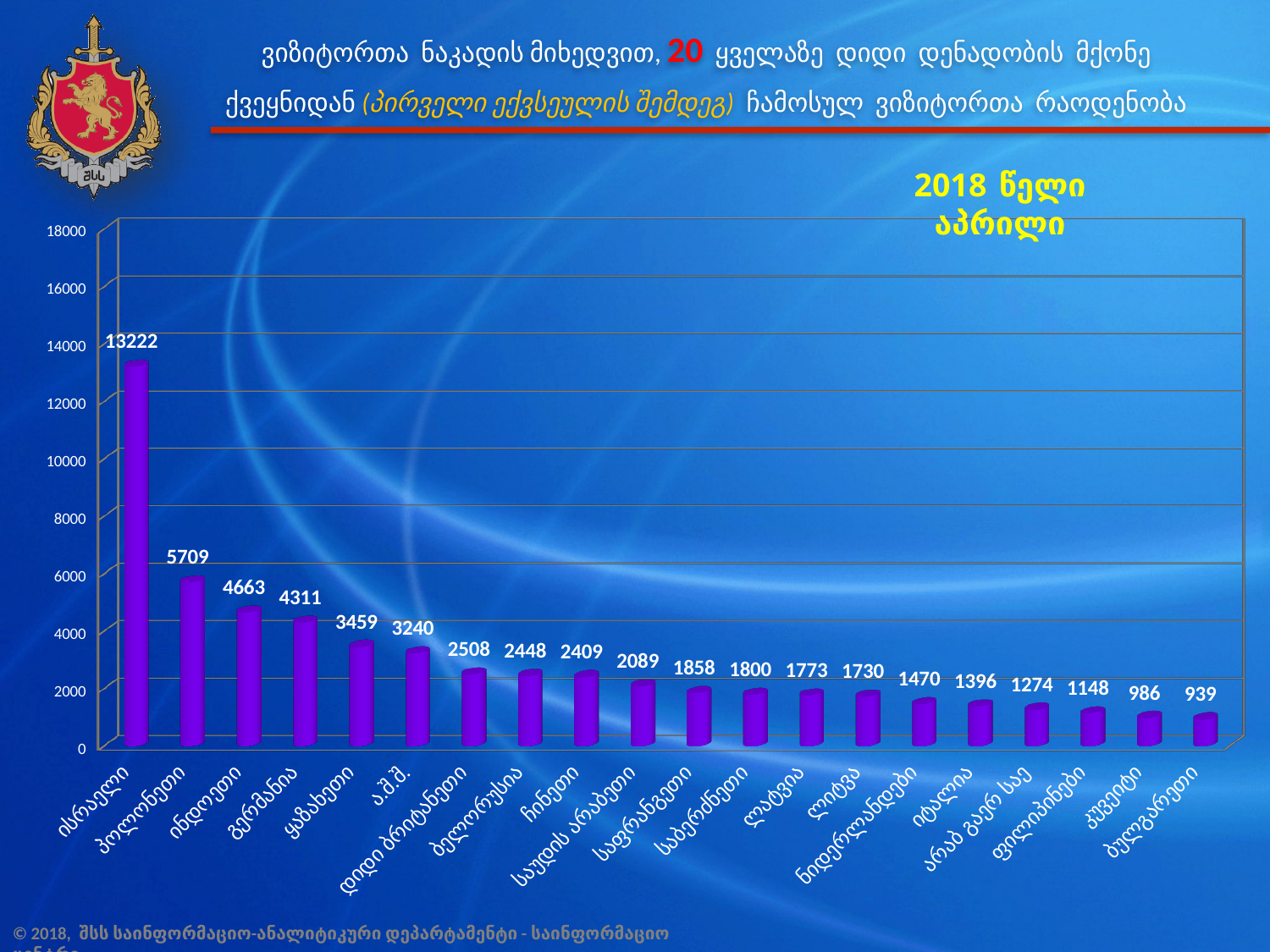
What is the difference between the values for ისრაელი (13222) and პოლონეთი (5709)? 7513 Which country has the lowest value in the chart? ბულგარეთი What type of chart is shown on the slide? bar chart What is the value for ჩინეთი (China) in the chart? 2409 What year and month are shown in the yellow label above the chart? 2018 წელი აპრილი Which country has the highest value in the chart? ისრაელი Which has a larger value, გერმანია (Germany) or ყაზახეთი (Kazakhstan)? გერმანია What is the value for პოლონეთი (Poland) in the chart? 5709 What is the value for ბულგარეთი (Bulgaria) in the chart? 939 Do the values rise or fall moving from left to right along the x axis? fall How many countries (bars) are plotted in the chart? 20 What is the value for ისრაელი (Israel) in the chart? 13222